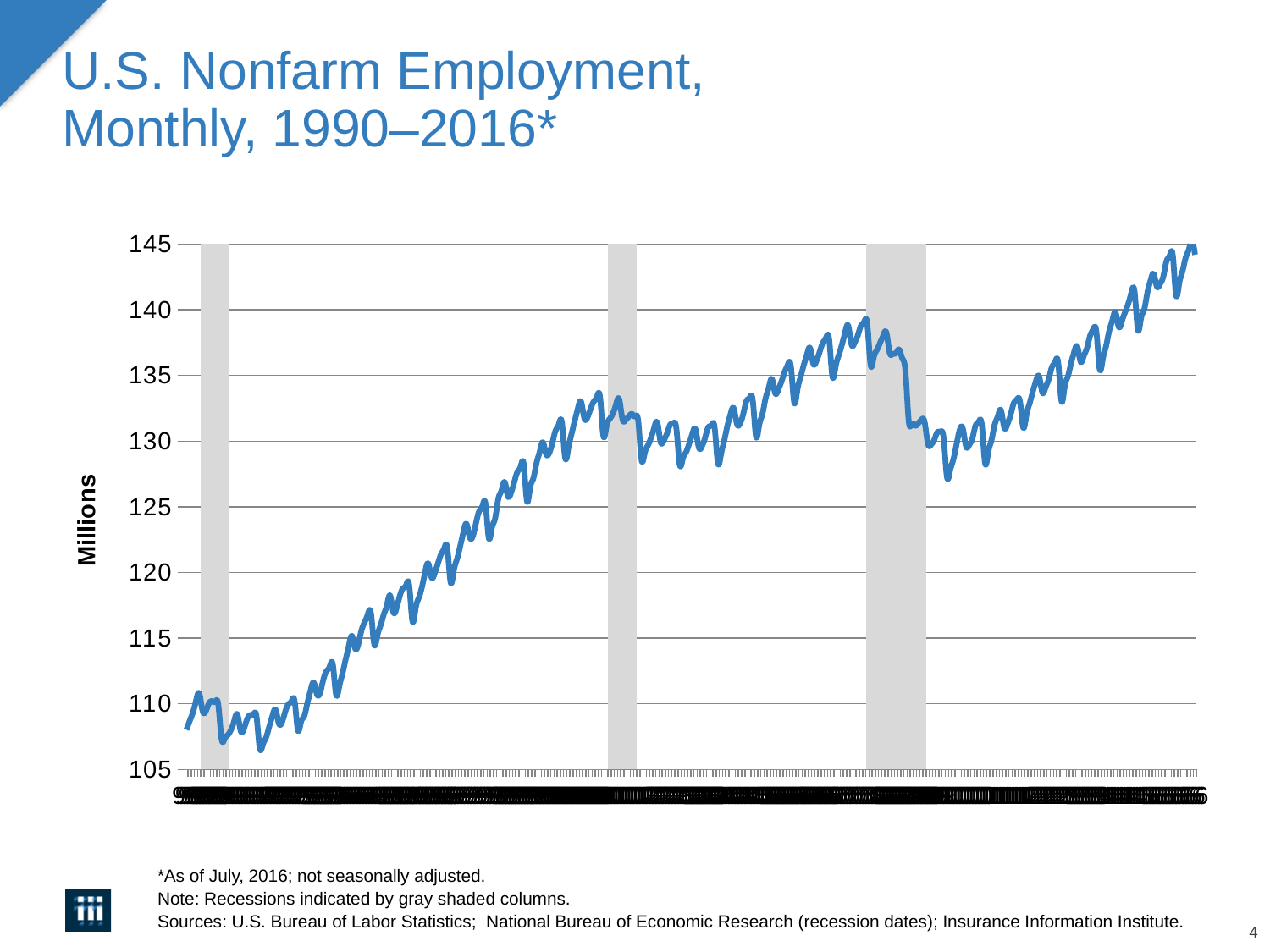
Do the values rise or fall during the third gray shaded recession column? fall Do the values rise or fall between the first and second gray shaded recession columns? rise Is the value at the end of the third gray shaded recession column greater or less than 135? less Is the value at the end of the series (July 2016) greater or less than 140? greater Is the lowest value on the chart greater or less than 110? less What kind of chart is shown on the slide? line chart How many gray shaded recession columns are shown on the chart? 3 Overall, do the values rise or fall from the start of the series in 1990 to the end in 2016? rise What is the label on the vertical axis? Millions